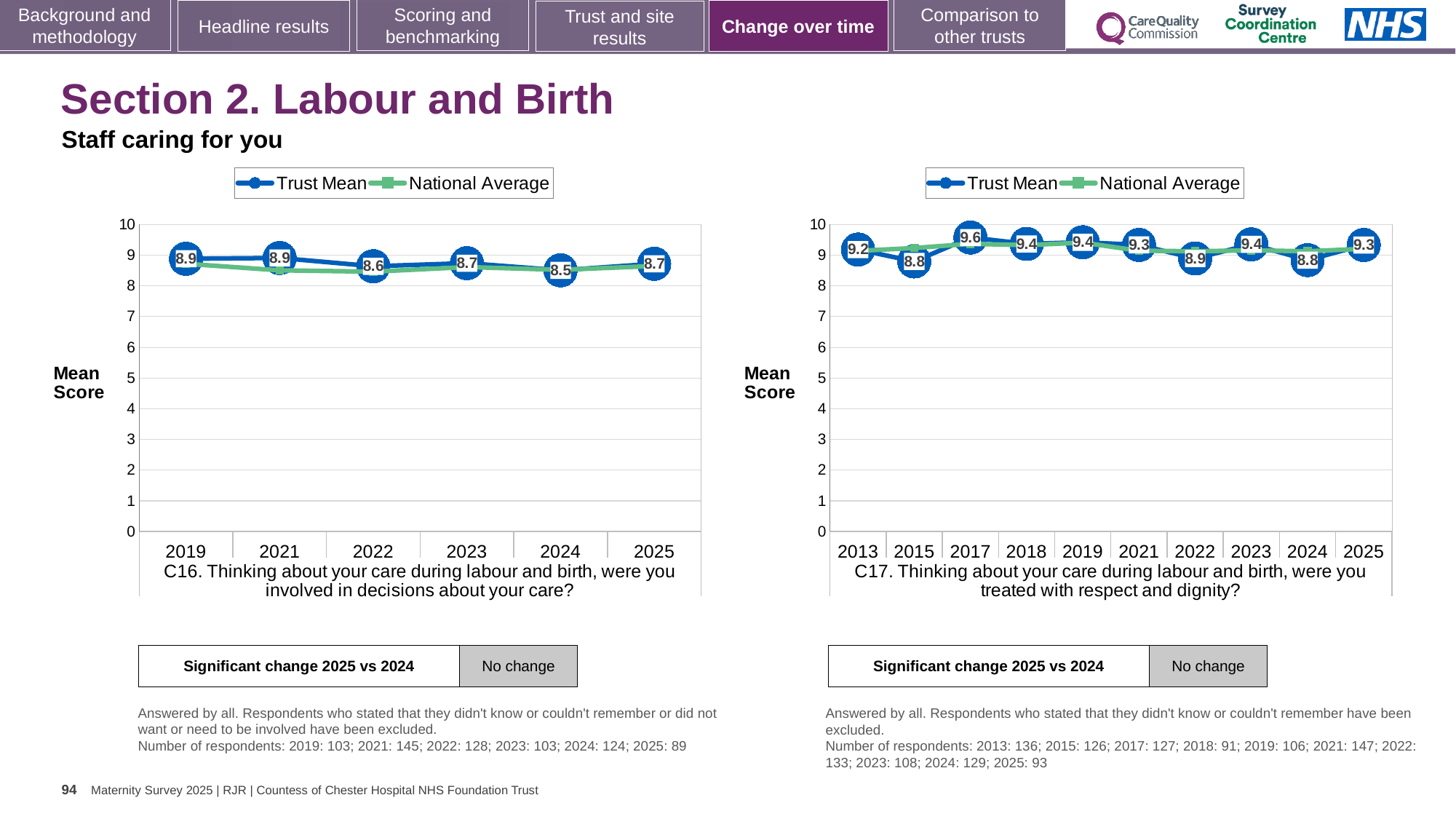
In the C16 chart on the left, what is the Trust Mean score for 2025? 8.7 In the C17 chart on the right, what is the Trust Mean score for 2017? 9.6 In the C17 chart on the right, what is the Trust Mean score for 2025? 9.3 In the C17 chart on the right, what is the difference between the Trust Mean scores for 2017 and 2024? 0.8 In the C16 chart on the left, what is the difference between the Trust Mean scores for 2019 and 2024? 0.4 In the C17 chart on the right, which year has the highest Trust Mean score? 2017 In the C16 chart on the left, which year has the lowest Trust Mean score? 2024 In the C16 chart on the left, how many years are plotted on the x axis? 6 What kind of chart is the C17 chart on the right? Line chart In the C16 chart on the left, what is the Trust Mean score for 2024? 8.5 In the C17 chart on the right, how many years are plotted on the x axis? 10 How many series does the legend of the C16 chart on the left list? 2